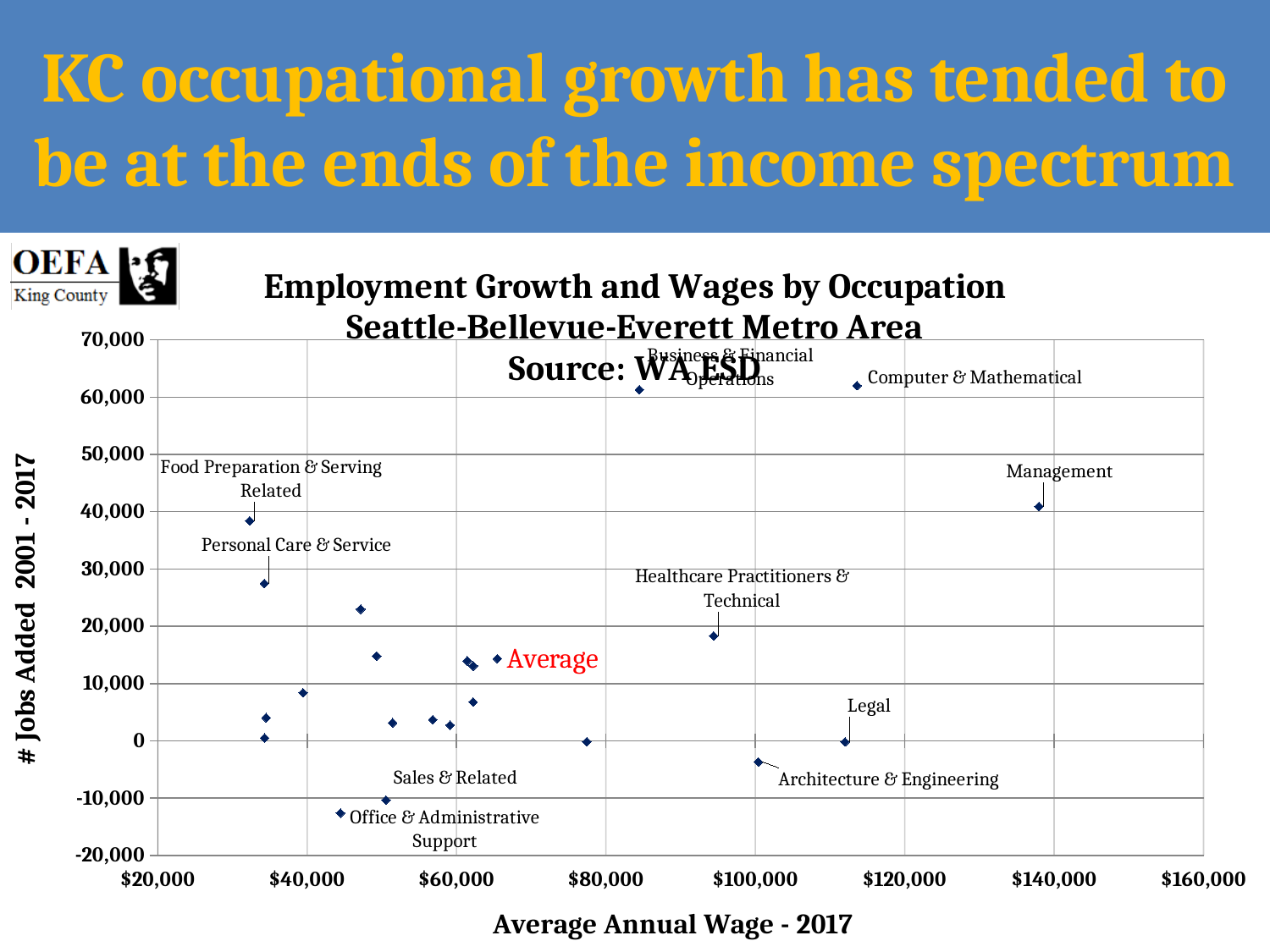
Which added more jobs, Management or Healthcare Practitioners & Technical? Management Is the number of jobs added for Office & Administrative Support greater or less than -10,000? less Is the average annual wage for Computer & Mathematical greater or less than $100,000? greater Is the number of jobs added for Management greater or less than 30,000? greater What is the title of the x axis of the chart? Average Annual Wage - 2017 What is the title of the y axis of the chart? # Jobs Added 2001 - 2017 What kind of chart is shown on the slide? Scatter chart Which occupation has the highest average annual wage on the chart? Management